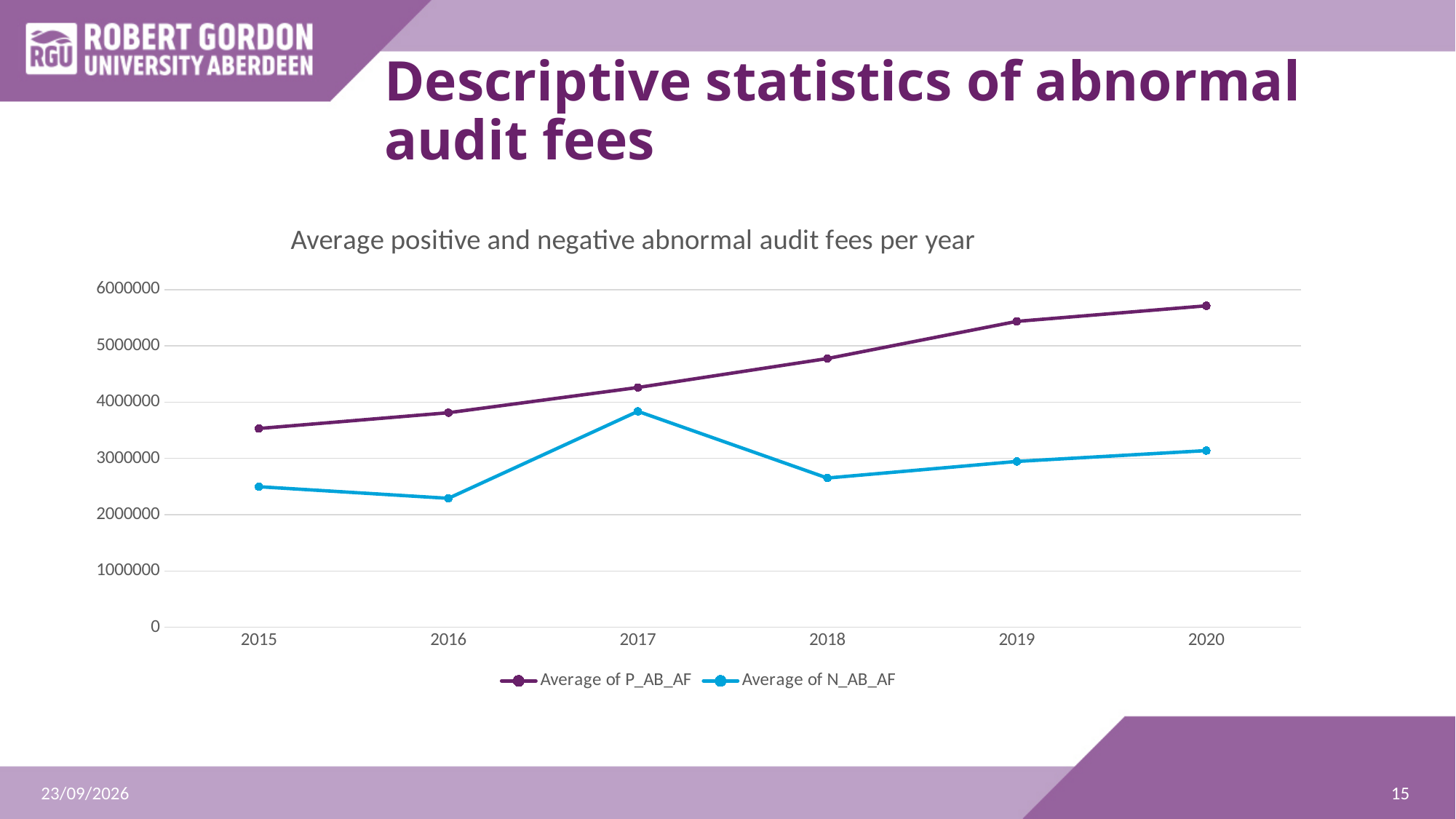
In which year is Average of N_AB_AF highest? 2017 What is the title of the chart? Average positive and negative abnormal audit fees per year How many series does the legend list? 2 In which year is Average of P_AB_AF highest? 2020 How many years are plotted along the x axis? 6 Is the value for Average of P_AB_AF in 2020 greater or less than 5000000? greater Is the value for Average of N_AB_AF in 2018 greater or less than 3000000? less In which year is Average of N_AB_AF lowest? 2016 In which year is Average of P_AB_AF lowest? 2015 Does Average of P_AB_AF rise or fall from 2015 to 2020? rise What kind of chart is shown on the slide? line chart Is the value for Average of P_AB_AF in 2015 greater or less than 4000000? less